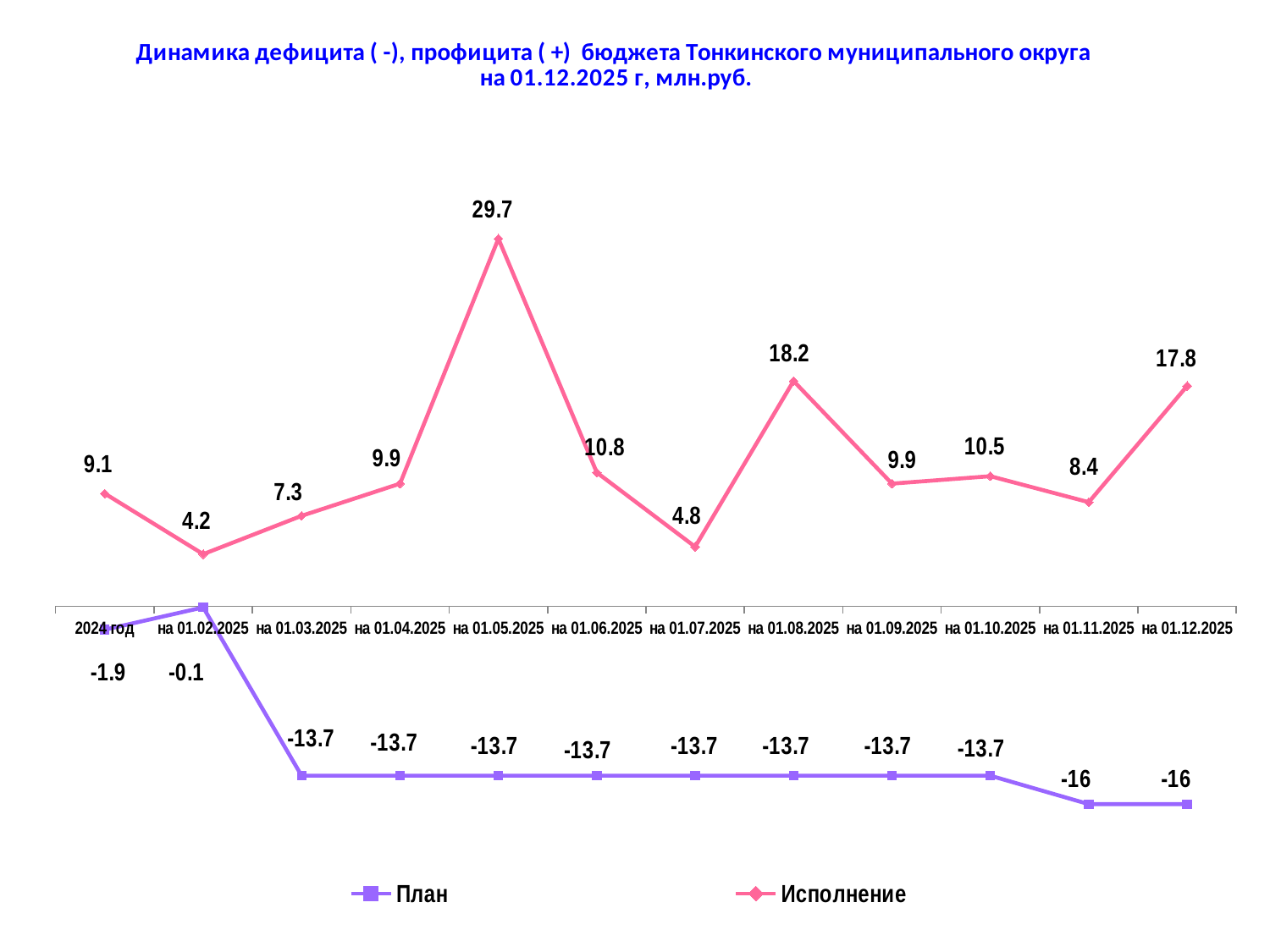
What is the value of План на 01.12.2025? -16 What is the value of Исполнение for 2024 год? 9.1 At which date is the Исполнение value lowest? на 01.02.2025 Which is larger: Исполнение на 01.12.2025 or Исполнение на 01.11.2025? на 01.12.2025 What type of chart is shown on the slide? line chart How many series does the legend list? 2 What is the value of План на 01.06.2025? -13.7 At which date does Исполнение reach its highest value? на 01.05.2025 How many data points are plotted along the x axis for each series? 12 What is the difference between Исполнение на 01.08.2025 and Исполнение на 01.07.2025? 13.4 Which series is drawn in pink with diamond markers? Исполнение What is the value of Исполнение на 01.05.2025? 29.7